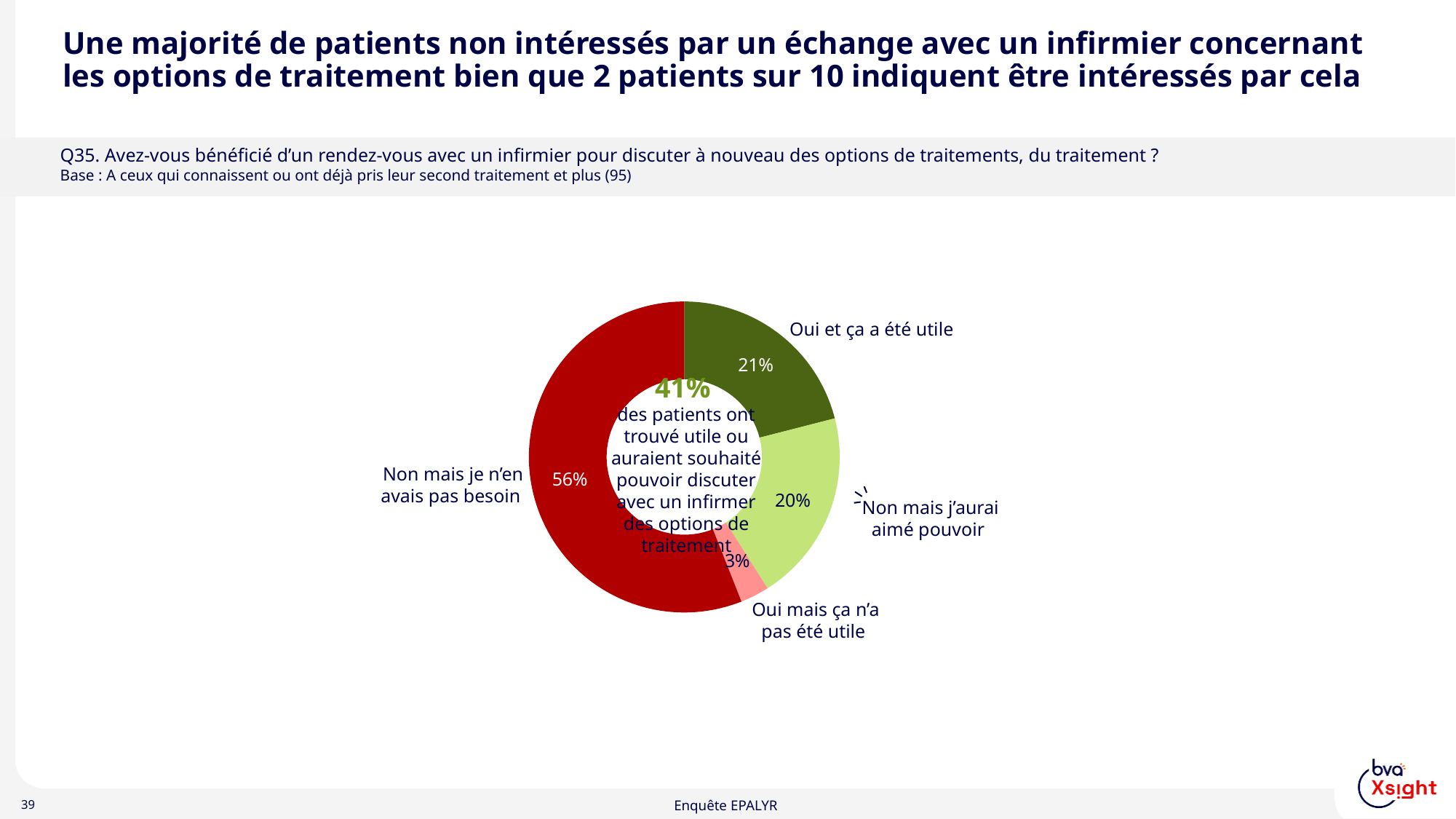
What share of patients answered "Non mais j'aurai aimé pouvoir"? 20% Which is larger: the share for "Oui et ça a été utile" or the share for "Oui mais ça n'a pas été utile"? Oui et ça a été utile What kind of chart is shown on the slide? Doughnut (pie) chart What is the difference in percentage points between "Non mais je n'en avais pas besoin" and "Oui et ça a été utile"? 35 percentage points What share of patients answered "Non mais je n'en avais pas besoin"? 56% Which response category has the largest share? Non mais je n'en avais pas besoin What share of patients answered "Oui mais ça n'a pas été utile"? 3% What is the combined share of the two "Oui" responses? 24% What share of patients answered "Oui et ça a été utile"? 21% Which response category has the smallest share? Oui mais ça n'a pas été utile What percentage is highlighted in the centre of the doughnut chart? 41% How many response categories are shown in the chart? 4